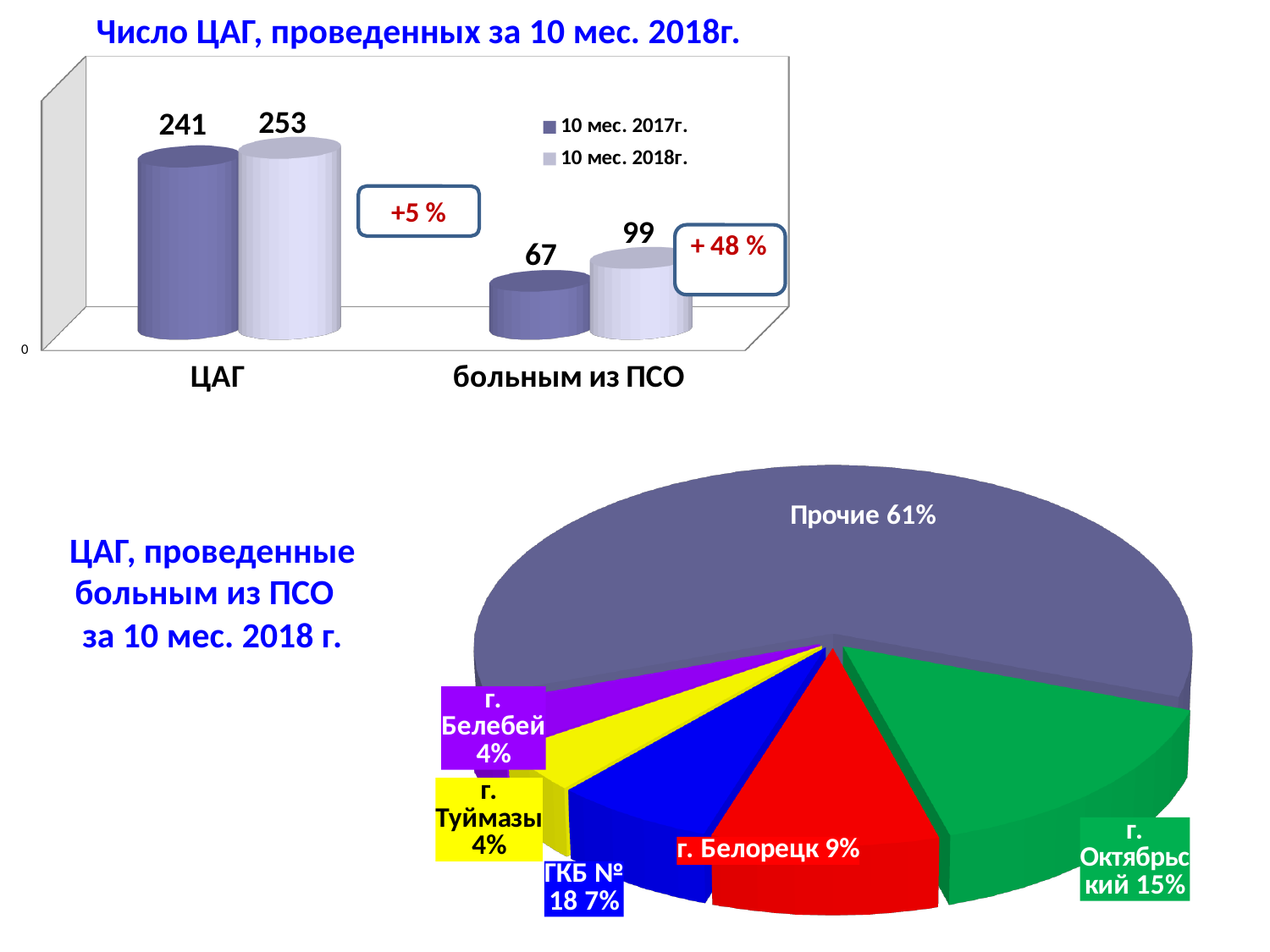
In the bar chart 'Число ЦАГ, проведенных за 10 мес. 2018г.', which is larger for ЦАГ: the '10 мес. 2017г.' value or the '10 мес. 2018г.' value? 10 мес. 2018г. What type of chart is the top chart 'Число ЦАГ, проведенных за 10 мес. 2018г.'? Bar chart In the pie chart 'ЦАГ, проведенные больным из ПСО за 10 мес. 2018 г.', what share does 'Прочие' have? 61% In the pie chart 'ЦАГ, проведенные больным из ПСО за 10 мес. 2018 г.', what share does 'г. Октябрьский' have? 15% How many slices does the pie chart 'ЦАГ, проведенные больным из ПСО за 10 мес. 2018 г.' have? 6 In the bar chart 'Число ЦАГ, проведенных за 10 мес. 2018г.', what is the value for ЦАГ in the series '10 мес. 2017г.'? 241 In the bar chart 'Число ЦАГ, проведенных за 10 мес. 2018г.', what is the value for 'больным из ПСО' in the series '10 мес. 2018г.'? 99 In the pie chart 'ЦАГ, проведенные больным из ПСО за 10 мес. 2018 г.', which labelled slice is the largest? Прочие In the bar chart 'Число ЦАГ, проведенных за 10 мес. 2018г.', what is the value for ЦАГ in the series '10 мес. 2018г.'? 253 How many series does the legend of the bar chart 'Число ЦАГ, проведенных за 10 мес. 2018г.' list? 2 In the bar chart 'Число ЦАГ, проведенных за 10 мес. 2018г.', what is the difference between the 2018 and 2017 values for 'больным из ПСО'? 32 In the pie chart 'ЦАГ, проведенные больным из ПСО за 10 мес. 2018 г.', what is the difference between the shares of 'г. Белорецк' and 'ГКБ № 18'? 2%